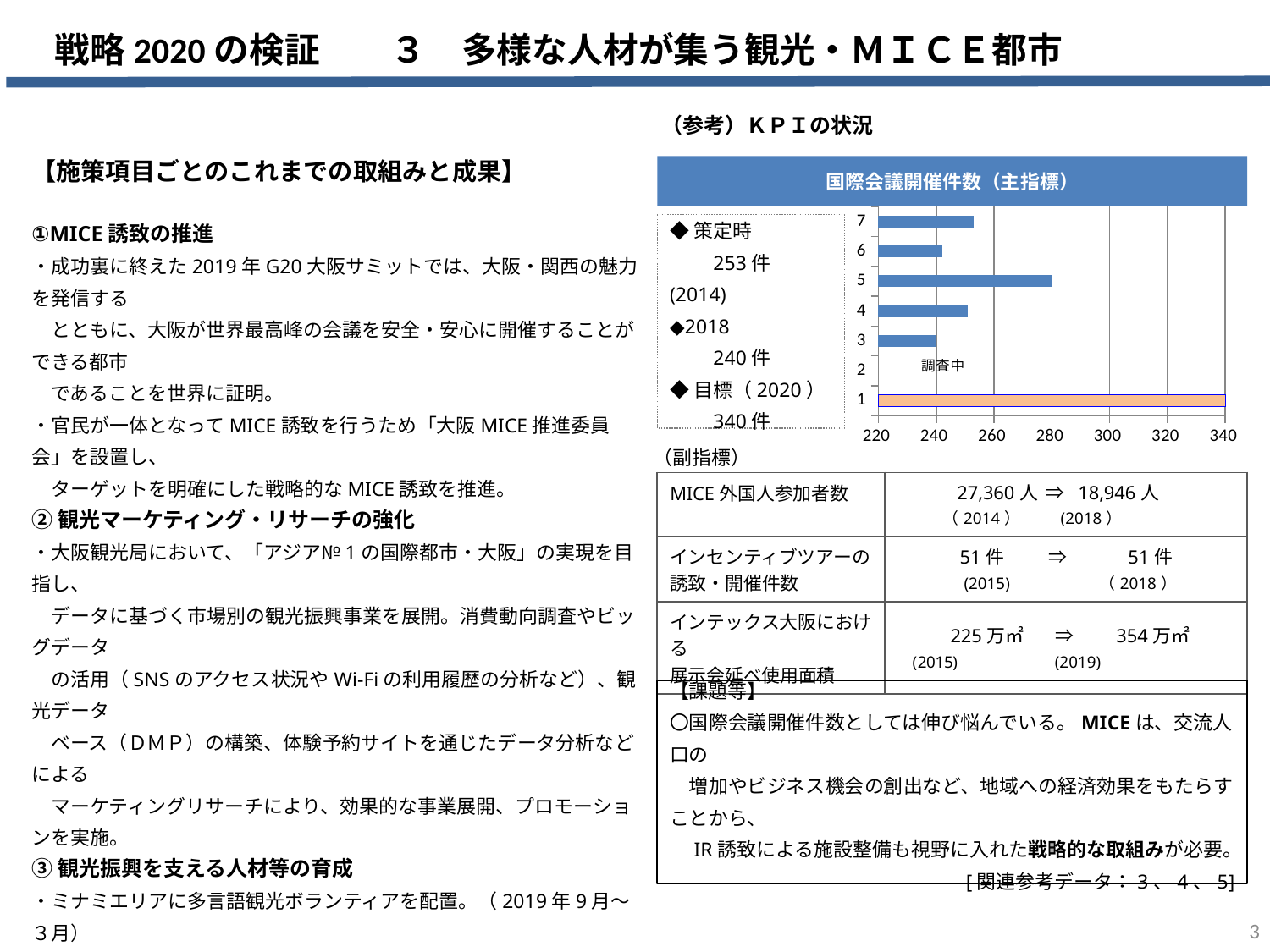
In the 国際会議開催件数（主指標） chart, is the value for category 5 greater or less than 260? greater In the 国際会議開催件数（主指標） chart, is the value for category 7 greater or less than 240? greater How many categories are listed on the vertical axis of the 国際会議開催件数（主指標） chart? 7 What kind of chart is shown under the title 国際会議開催件数（主指標）? bar chart In the 国際会議開催件数（主指標） chart, what value does the bar for category 1 reach on the horizontal axis? 340 In the 国際会議開催件数（主指標） chart, is the value for category 4 greater or less than 260? less In the 国際会議開催件数（主指標） chart, what text is shown in place of a bar for category 2? 調査中 What is the lowest value shown on the horizontal axis of the 国際会議開催件数（主指標） chart? 220 In the 国際会議開催件数（主指標） chart, is the bar for category 5 longer or shorter than the bar for category 7? longer In the 国際会議開催件数（主指標） chart, which category has the longest bar? 1 In the 国際会議開催件数（主指標） chart, which of the blue bars (categories 3 to 7) is the longest? 5